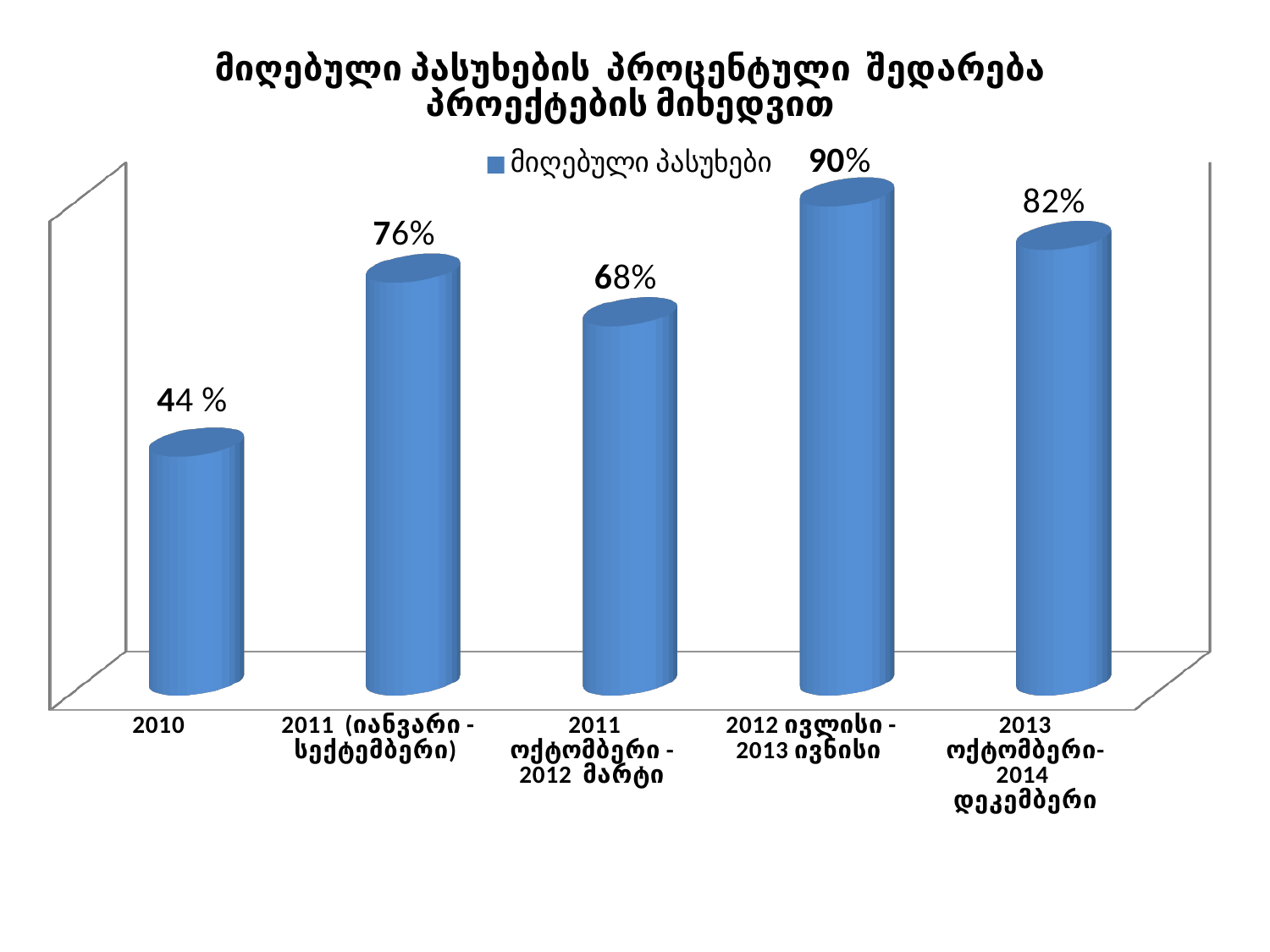
What is the value for 2013 ოქტომბერი- 2014 დეკემბერი? 82% What is the value for 2011 (იანვარი - სექტემბერი)? 76% What is the difference between the values for 2012 ივლისი - 2013 ივნისი and 2010? 46% What kind of chart is shown on the slide? bar chart Which is larger, the value for 2011 (იანვარი - სექტემბერი) or the value for 2011 ოქტომბერი - 2012 მარტი? 2011 (იანვარი - სექტემბერი) What is the value for 2012 ივლისი - 2013 ივნისი? 90% What is the value for 2010? 44 % How many series does the legend list? 1 What is the value for 2011 ოქტომბერი - 2012 მარტი? 68% Which category has the highest value? 2012 ივლისი - 2013 ივნისი How many categories are shown on the x axis? 5 Which category has the lowest value? 2010